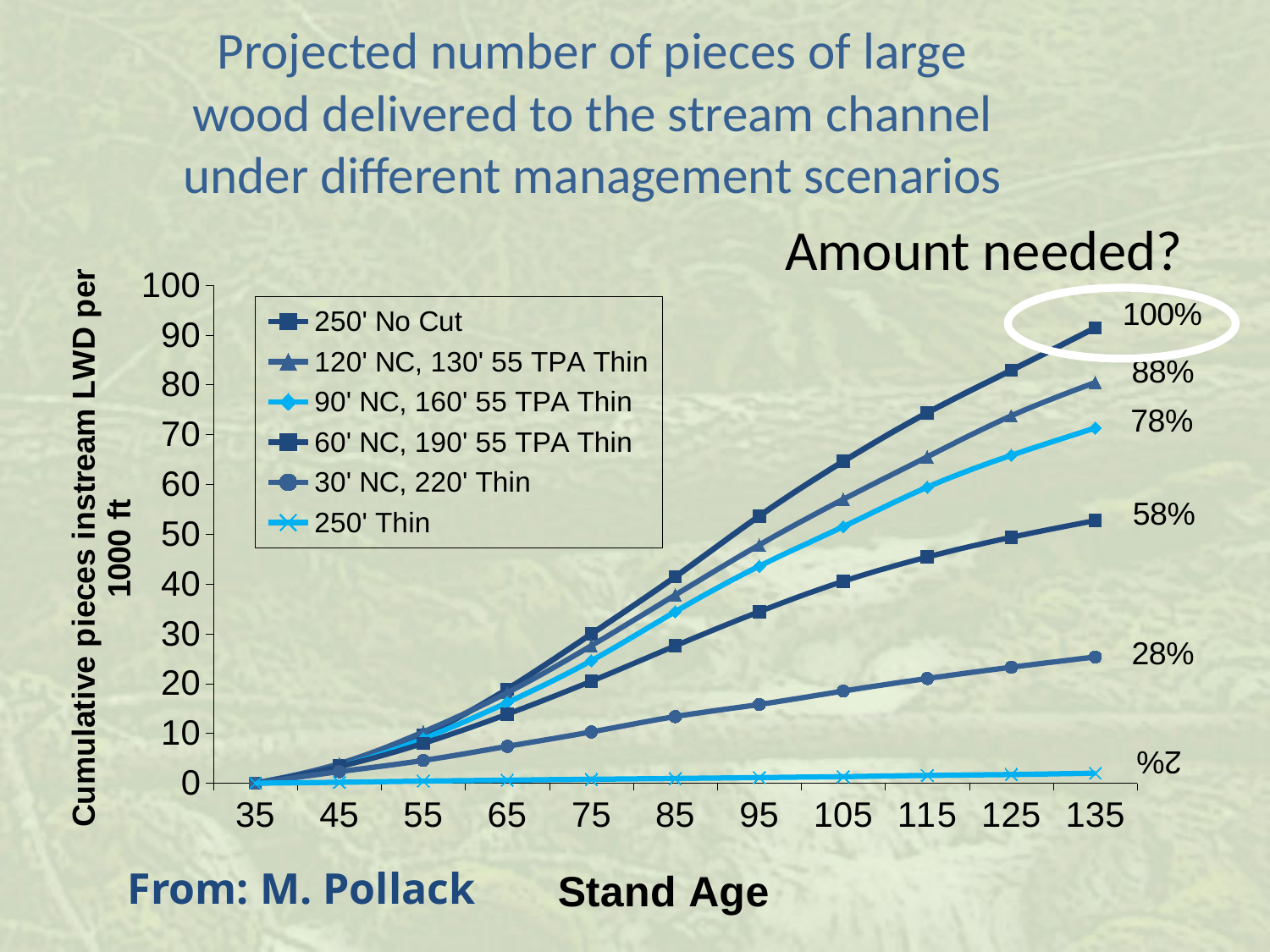
Is the value for 250' Thin at stand age 135 greater or less than 10? less What kind of chart is shown on the slide? line chart At stand age 135, which series is higher: 120' NC, 130' 55 TPA Thin or 90' NC, 160' 55 TPA Thin? 120' NC, 130' 55 TPA Thin Do the values for 250' No Cut rise or fall as stand age increases? rise Which series has the highest value at stand age 135? 250' No Cut How many series does the legend list? 6 How many stand age values are marked along the x axis? 11 What percentage label is printed at the end of the 60' NC, 190' 55 TPA Thin line? 58% Is the value for 30' NC, 220' Thin at stand age 135 greater or less than 20? greater Is the value for 250' No Cut at stand age 135 greater or less than 80? greater What is the title of the x axis? Stand Age Which series has the lowest value at stand age 135? 250' Thin